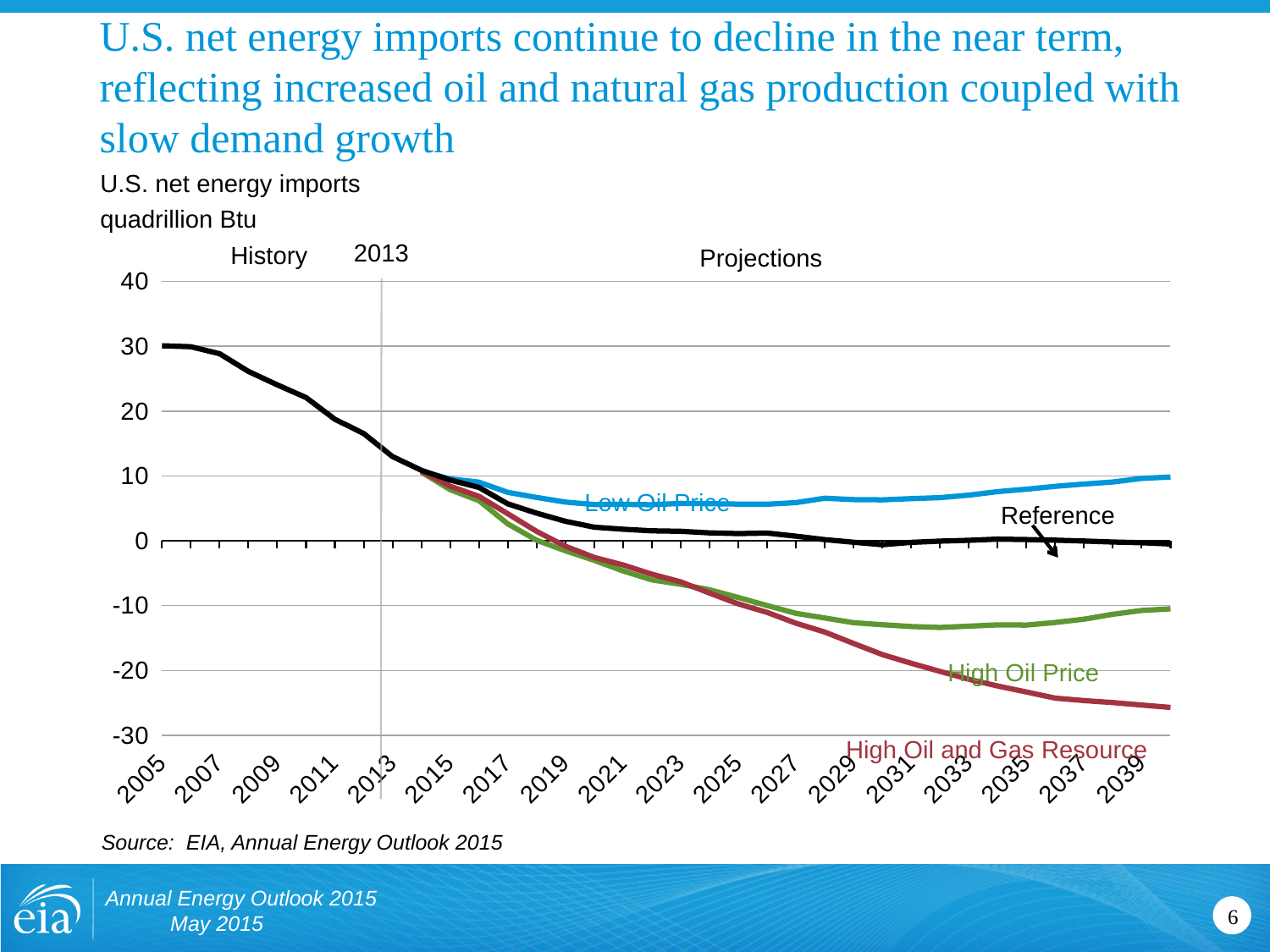
Is the value of net energy imports in 2013 greater or less than 20? less Which series has the highest value in 2039? Low Oil Price Is the value for High Oil Price in 2031 greater or less than -10? less Which year marks the boundary between History and Projections on the chart? 2013 Which series has the lowest value in 2039? High Oil and Gas Resource Is the value for High Oil and Gas Resource in 2039 greater or less than -20? less In 2039, which is larger: the High Oil Price value or the High Oil and Gas Resource value? High Oil Price What unit is used on the y axis of the chart? quadrillion Btu What kind of chart is shown on the slide? line chart How many projection series (scenarios) are labeled on the chart? 4 Do U.S. net energy imports rise or fall between 2005 and 2013? fall